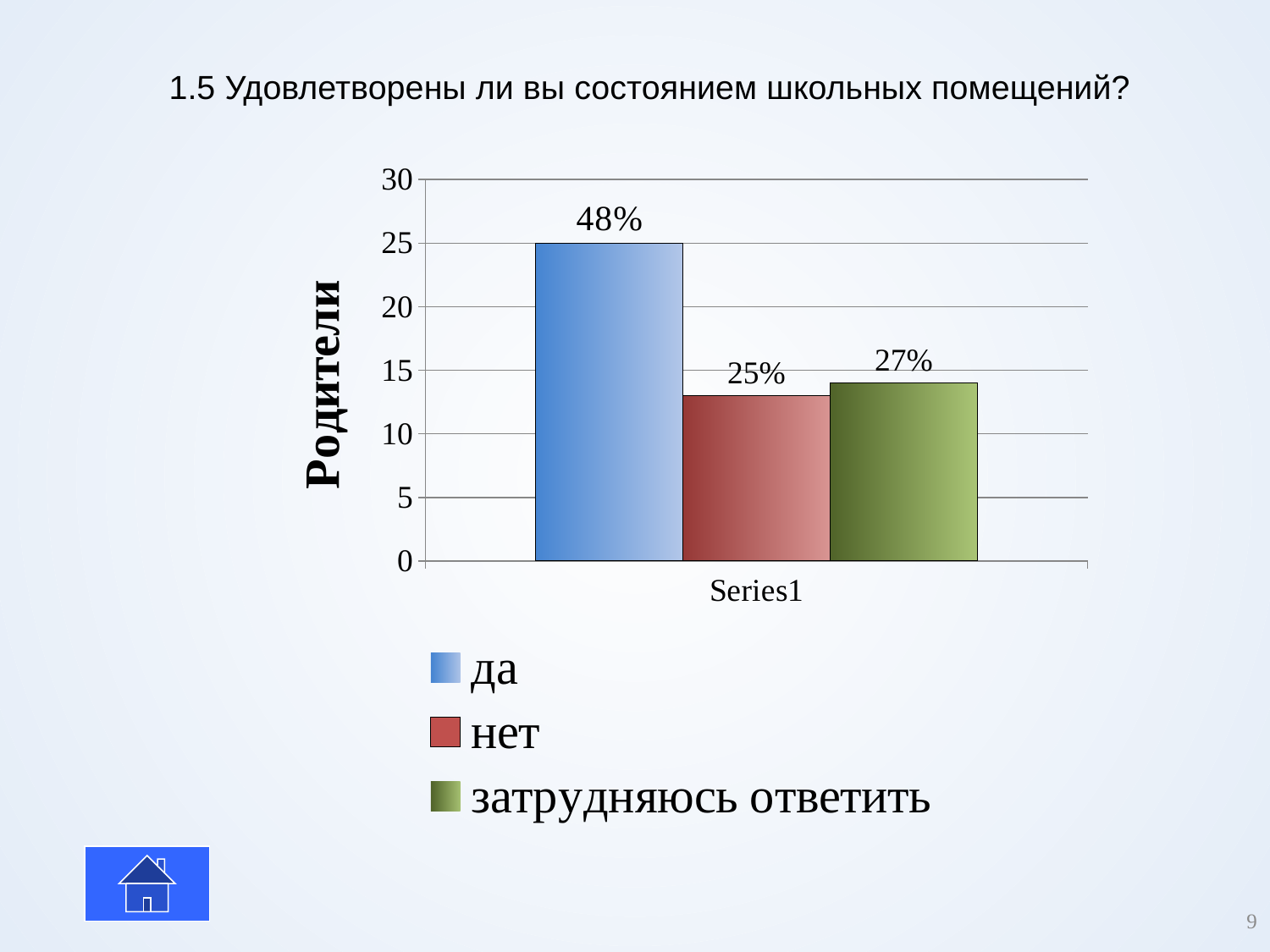
What kind of chart is shown on the slide? bar chart Which is larger, the bar for "затрудняюсь ответить" or the bar for "нет"? затрудняюсь ответить What is the difference between the labels for "затрудняюсь ответить" and "нет"? 2% What is the title of the vertical axis? Родители What is the data label shown on the bar for "да"? 48% Is the bar for "нет" greater or less than 15 on the vertical axis? less Which answer option has the highest bar? да Which answer option has the lowest bar? нет By how many percentage points does the label for "да" exceed the label for "нет"? 23% What is the data label shown on the bar for "нет"? 25% How many bars are plotted in the chart? 3 What is the data label shown on the bar for "затрудняюсь ответить"? 27%